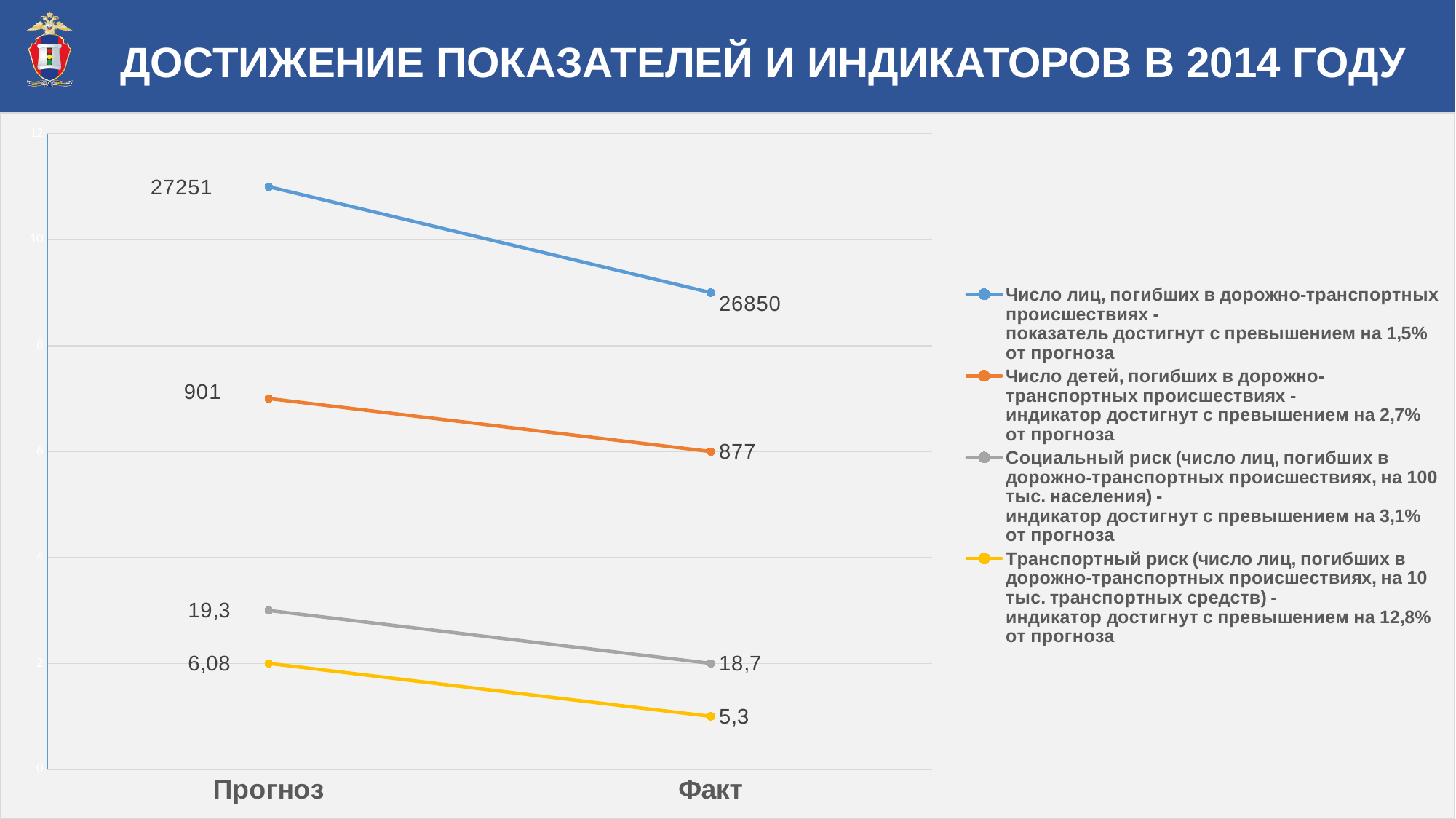
How many categories are shown on the x axis? 2 What is the actual (Факт) value for the series 'Социальный риск'? 18,7 What is the actual (Факт) value for the series 'Число лиц, погибших в дорожно-транспортных происшествиях'? 26850 Do the values of the 'Социальный риск' series rise or fall from Прогноз to Факт? fall What is the forecast (Прогноз) value for the series 'Транспортный риск'? 6,08 What is the forecast (Прогноз) value for the series 'Число лиц, погибших в дорожно-транспортных происшествиях'? 27251 Which is larger for 'Транспортный риск': the forecast (Прогноз) value or the actual (Факт) value? Прогноз What is the forecast (Прогноз) value for the series 'Число детей, погибших в дорожно-транспортных происшествиях'? 901 What is the difference between the forecast and actual values for 'Число детей, погибших в дорожно-транспортных происшествиях'? 24 What kind of chart is shown on the slide? line chart How many series does the legend list? 4 What is the difference between the forecast and actual values for 'Число лиц, погибших в дорожно-транспортных происшествиях'? 401